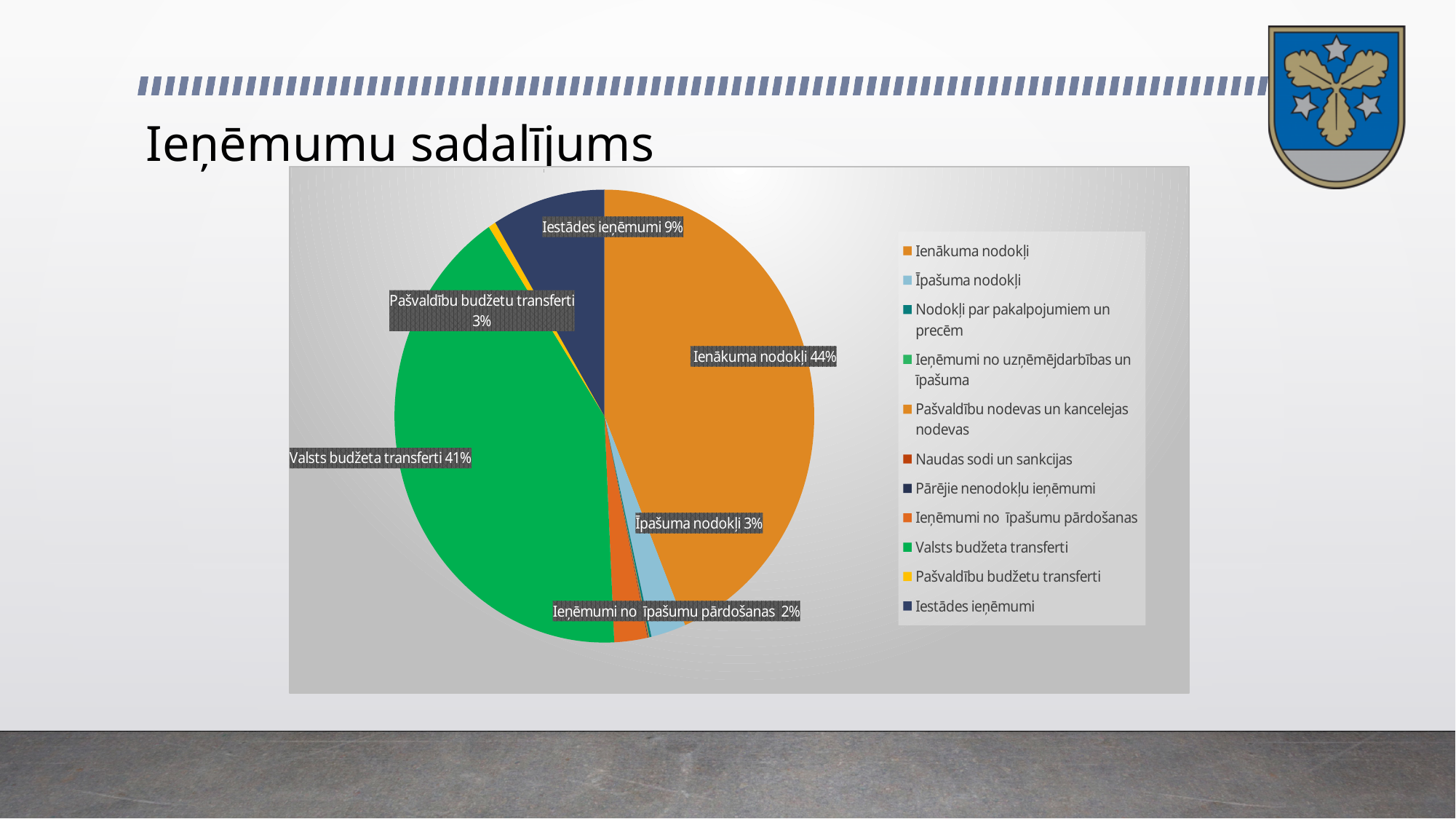
What share of the pie is Īpašuma nodokļi? 3% Which labelled slice has the smallest share of the pie? Ieņēmumi no īpašumu pārdošanas What share of the pie is Pašvaldību budžetu transferti? 3% What share of the pie is Ieņēmumi no īpašumu pārdošanas? 2% Which is larger, Iestādes ieņēmumi or Īpašuma nodokļi? Iestādes ieņēmumi What share of the pie is Ienākuma nodokļi? 44% What is the difference in percentage points between Ienākuma nodokļi and Valsts budžeta transferti? 3 How many entries does the legend list? 11 What share of the pie is Iestādes ieņēmumi? 9% What share of the pie is Valsts budžeta transferti? 41% Which labelled slice has the largest share of the pie? Ienākuma nodokļi What kind of chart is shown on the slide? pie chart